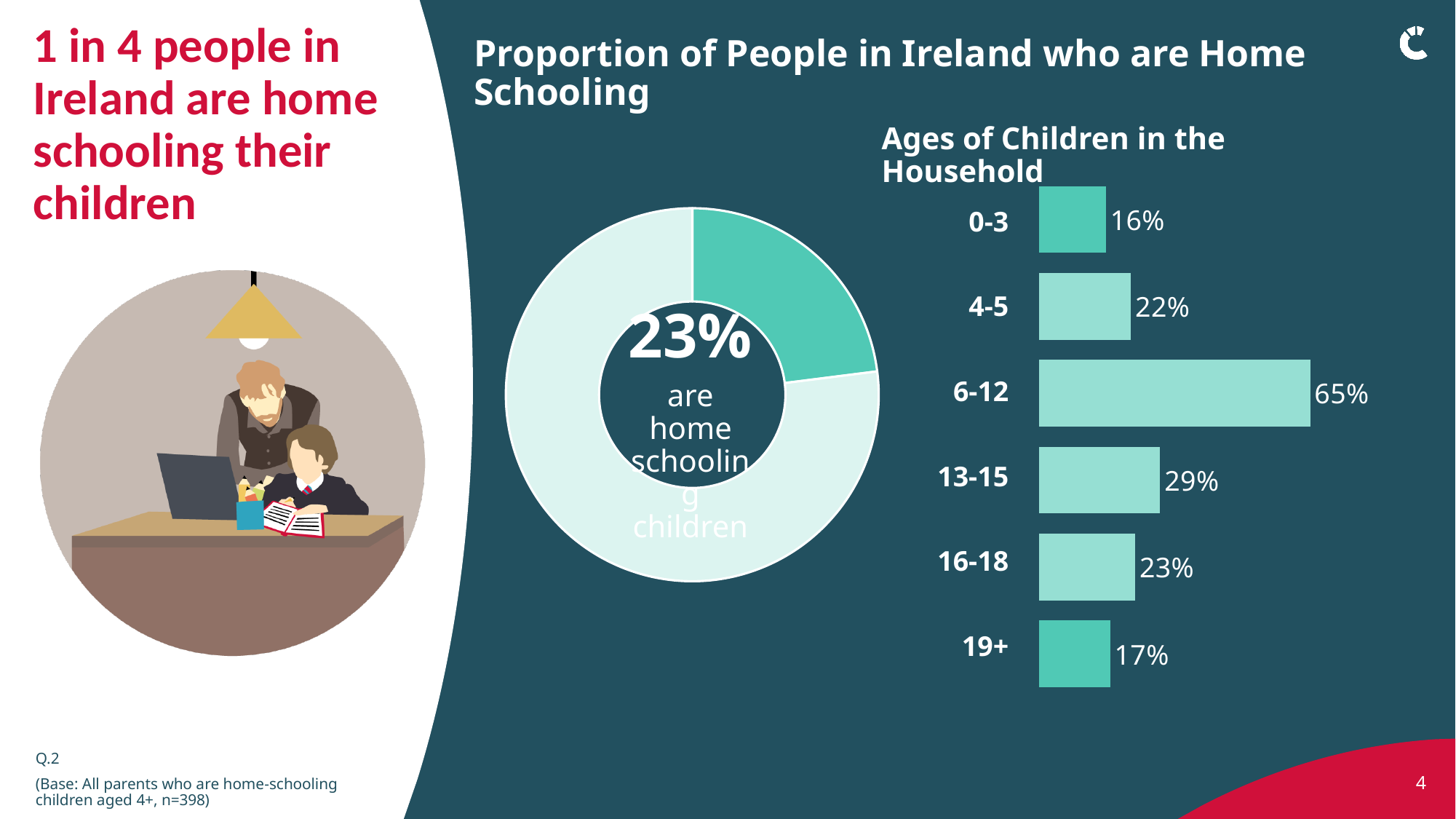
In the 'Ages of Children in the Household' bar chart, what is the value for the 6-12 age group? 65% In the 'Ages of Children in the Household' bar chart, what is the value for the 0-3 age group? 16% In the 'Ages of Children in the Household' bar chart, which is larger: the value for 4-5 or the value for 19+? 4-5 What kind of chart is the 'Ages of Children in the Household' chart? Bar chart In the donut chart on the slide, what percentage of people in Ireland are home schooling children? 23% How many age groups are shown in the 'Ages of Children in the Household' bar chart? 6 In the 'Ages of Children in the Household' bar chart, what is the difference between the values for 6-12 and 13-15? 36% In the 'Ages of Children in the Household' bar chart, which age group has the highest value? 6-12 In the 'Ages of Children in the Household' bar chart, what is the value for the 16-18 age group? 23% In the 'Ages of Children in the Household' bar chart, which age group has the lowest value? 0-3 What is the title of the chart on the right side of the slide? Ages of Children in the Household What kind of chart shows the proportion of people in Ireland who are home schooling? Donut chart